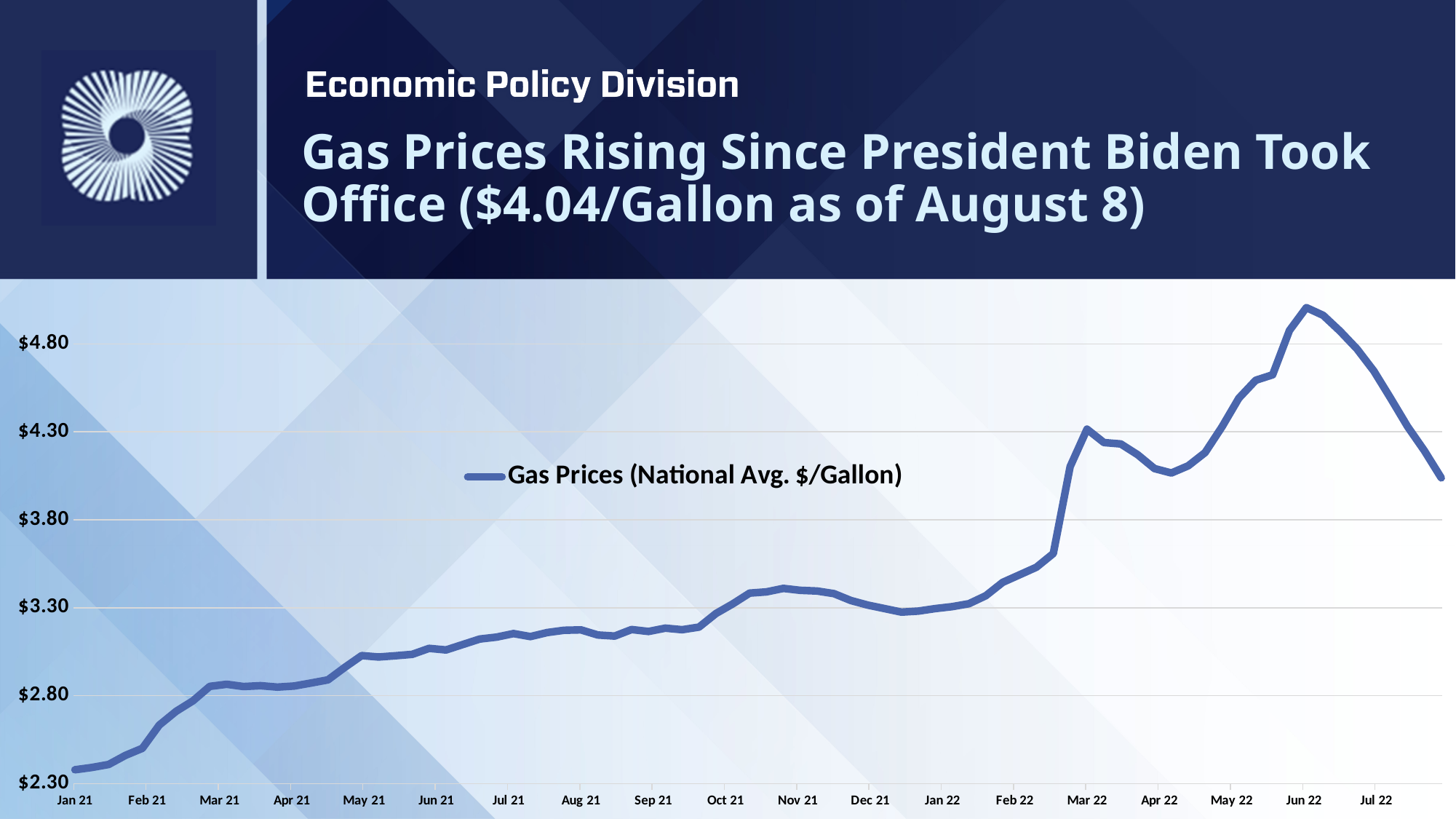
Is the peak gas price near Jun 22 greater or less than $4.80? greater What is the title of the chart on the slide? Gas Prices Rising Since President Biden Took Office ($4.04/Gallon as of August 8) Do gas prices generally rise or fall from Jan 21 to Jun 22? rise How many series does the legend list? 1 Around which month label does the gas price reach its highest point? Jun 22 Which is larger, the gas price at Jan 22 or at Jan 21? Jan 22 At which month label is the gas price lowest? Jan 21 Is the gas price at Nov 21 greater or less than $3.30? greater What is the legend entry for the plotted line? Gas Prices (National Avg. $/Gallon) How many month labels are shown on the x axis? 19 What kind of chart is shown on the slide? line chart Is the gas price at Jan 21 greater or less than $2.80? less